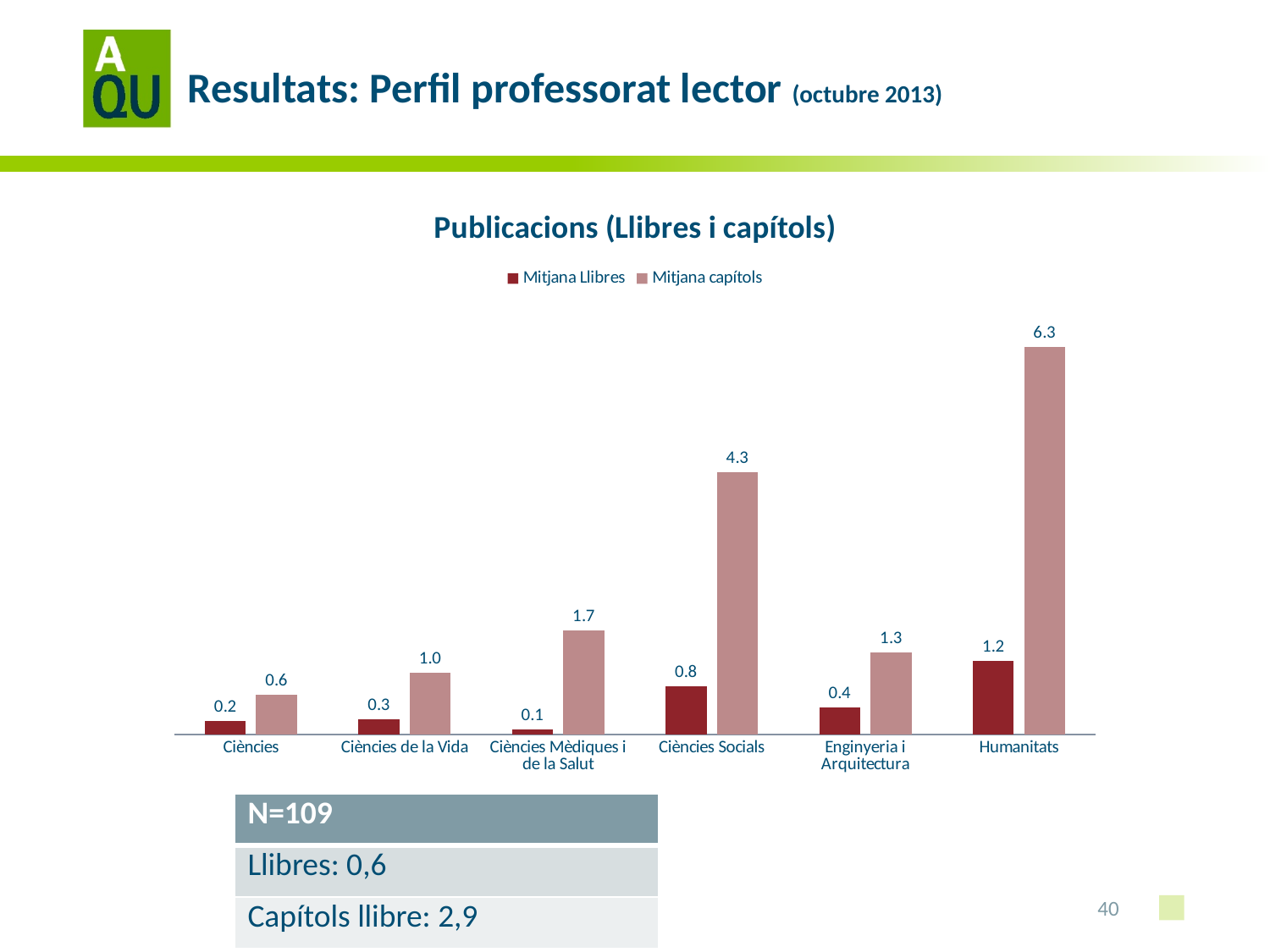
How many categories are shown on the x axis? 6 What is the Mitjana Llibres value for Enginyeria i Arquitectura? 0.4 What kind of chart is shown on the slide? Bar chart What is the Mitjana capítols value for Humanitats? 6.3 What is the title of the chart? Publicacions (Llibres i capítols) What is the Mitjana capítols value for Ciències Mèdiques i de la Salut? 1.7 What is the Mitjana Llibres value for Ciències Socials? 0.8 Which category has the lowest Mitjana Llibres value? Ciències Mèdiques i de la Salut Which is larger, the Mitjana Llibres value for Humanitats or for Ciències Socials? Humanitats Which category has the highest Mitjana capítols value? Humanitats What is the difference between the Mitjana capítols values for Humanitats and Ciències Socials? 2.0 How many series does the legend list? 2